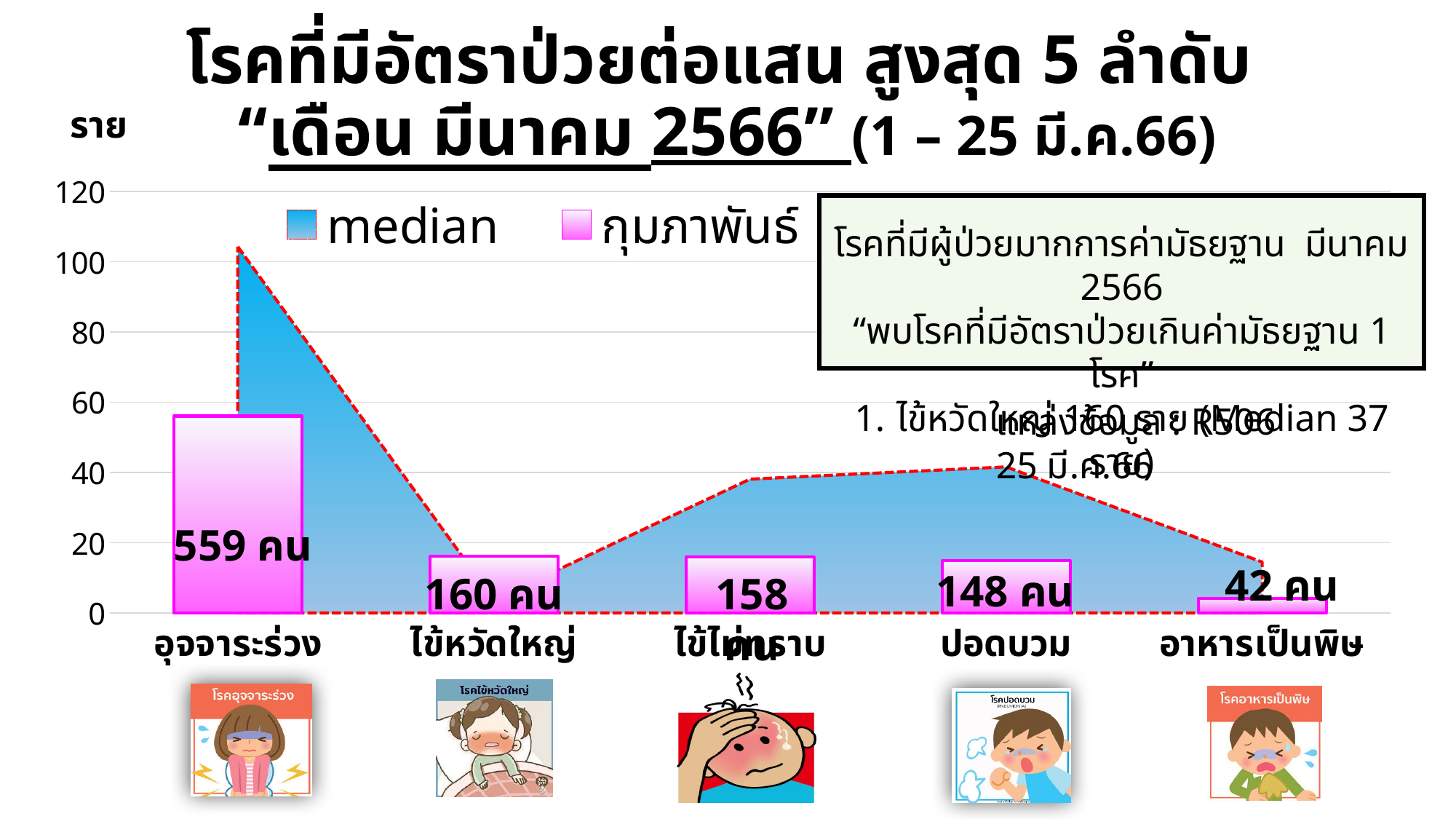
Which has the taller pink bar, อุจจาระร่วง or ไข้หวัดใหญ่? อุจจาระร่วง Which category has the shortest pink bar? อาหารเป็นพิษ How many series does the legend list? 2 How many disease categories are shown on the x axis? 5 Is the pink bar for อุจจาระร่วง greater or less than 40 on the axis? greater What data label is shown on the bar for ปอดบวม? 148 คน What data label is shown on the bar for อาหารเป็นพิษ? 42 คน Which category has the tallest pink bar? อุจจาระร่วง Is the median value for ปอดบวม greater or less than 20? greater What is the difference between the labelled values for ไข้หวัดใหญ่ (160 คน) and ปอดบวม (148 คน)? 12 คน Is the median value for ไข้หวัดใหญ่ greater or less than 40? less What data label is shown on the bar for อุจจาระร่วง? 559 คน